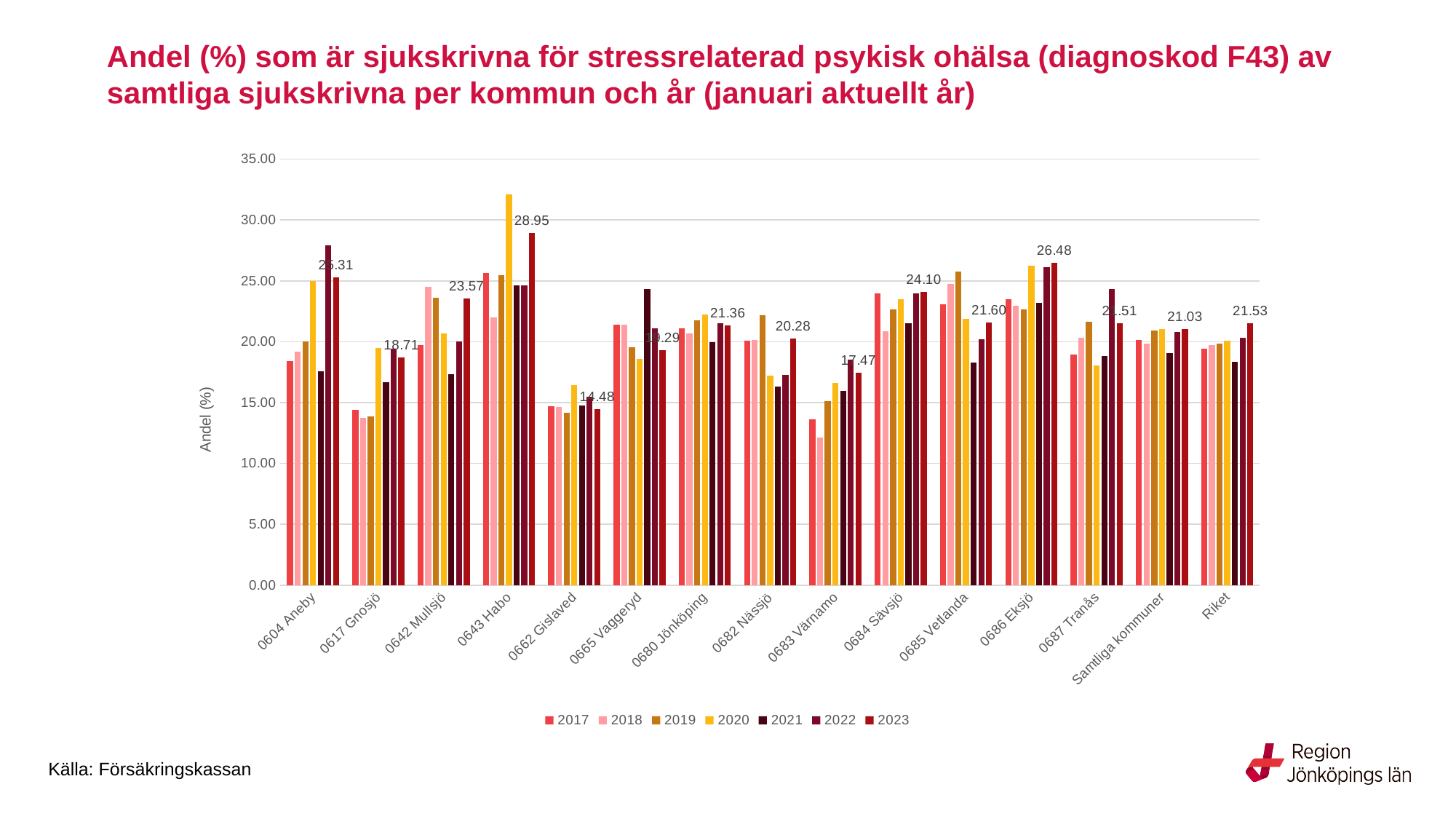
How many series does the legend list? 7 Is the 2018 value for 0683 Värnamo greater or less than 15.00? less What is the 2023 value for Riket? 21.53 What kind of chart is shown on the slide? Bar chart Is the 2020 value for 0643 Habo greater or less than 30.00? greater Which has the larger 2023 value, 0684 Sävsjö or 0683 Värnamo? 0684 Sävsjö What is the 2023 value for 0643 Habo? 28.95 What is the difference between the 2023 values for 0686 Eksjö and 0687 Tranås? 4.97 How many categories are shown on the x axis? 15 Which category has the highest 2023 value? 0643 Habo What is the 2023 value for 0662 Gislaved? 14.48 Which category has the lowest 2023 value? 0662 Gislaved